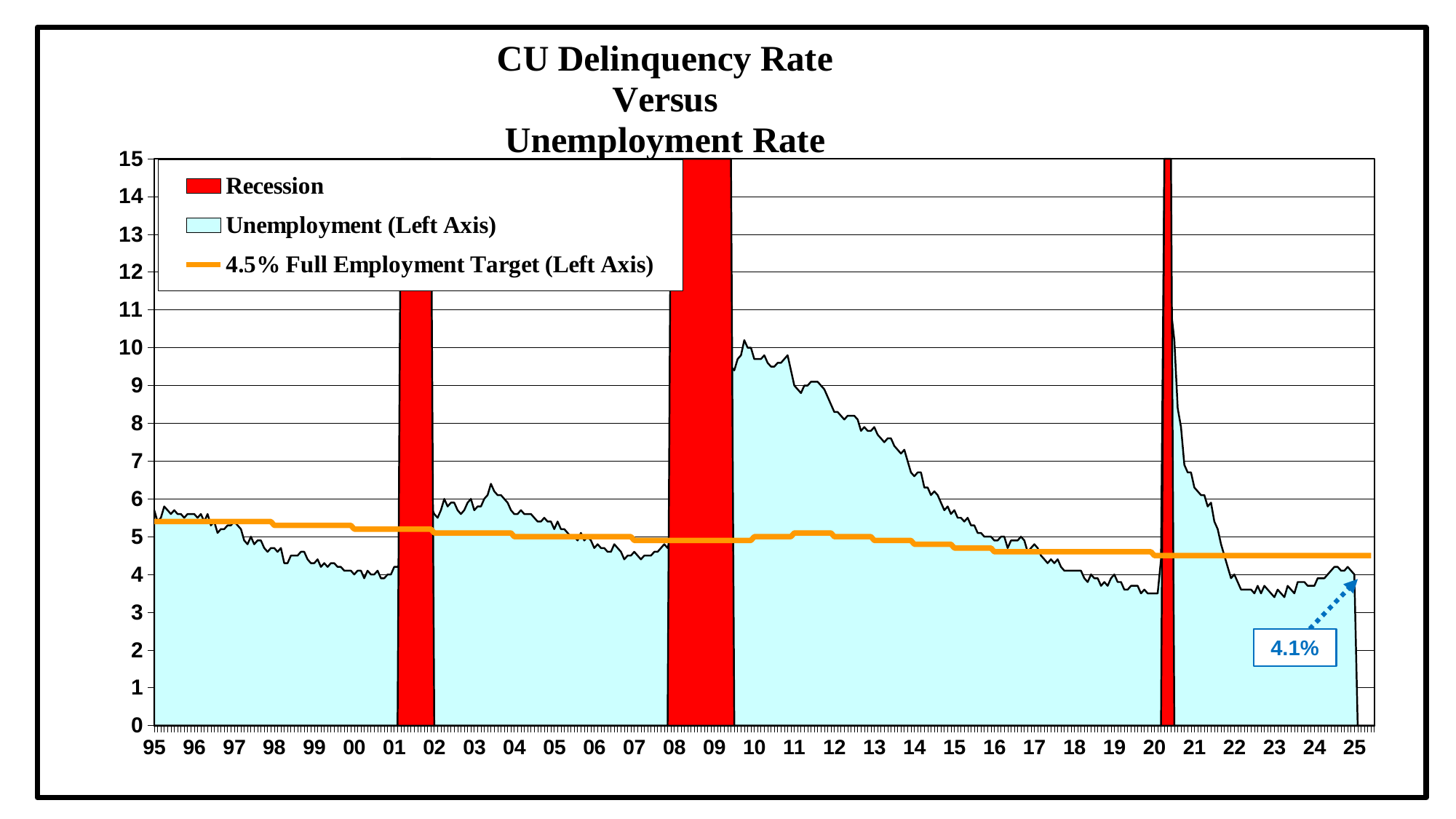
What is the title of the chart? CU Delinquency Rate Versus Unemployment Rate What full employment target value is stated in the legend? 4.5% Is the unemployment value in 2003 greater or less than 5? greater Is the unemployment value in 2000 greater or less than 5? less What kind of chart is used to plot the unemployment series? area chart How many entries does the chart's legend list? 3 Which year has the higher unemployment value, 2010 or 2000? 2010 Is the unemployment value in 2010 greater or less than 9? greater What value is labeled at the end of the unemployment series in 2025? 4.1% From 2010 to 2019, does the unemployment series rise or fall? fall How many recession bands are shown on the chart? 3